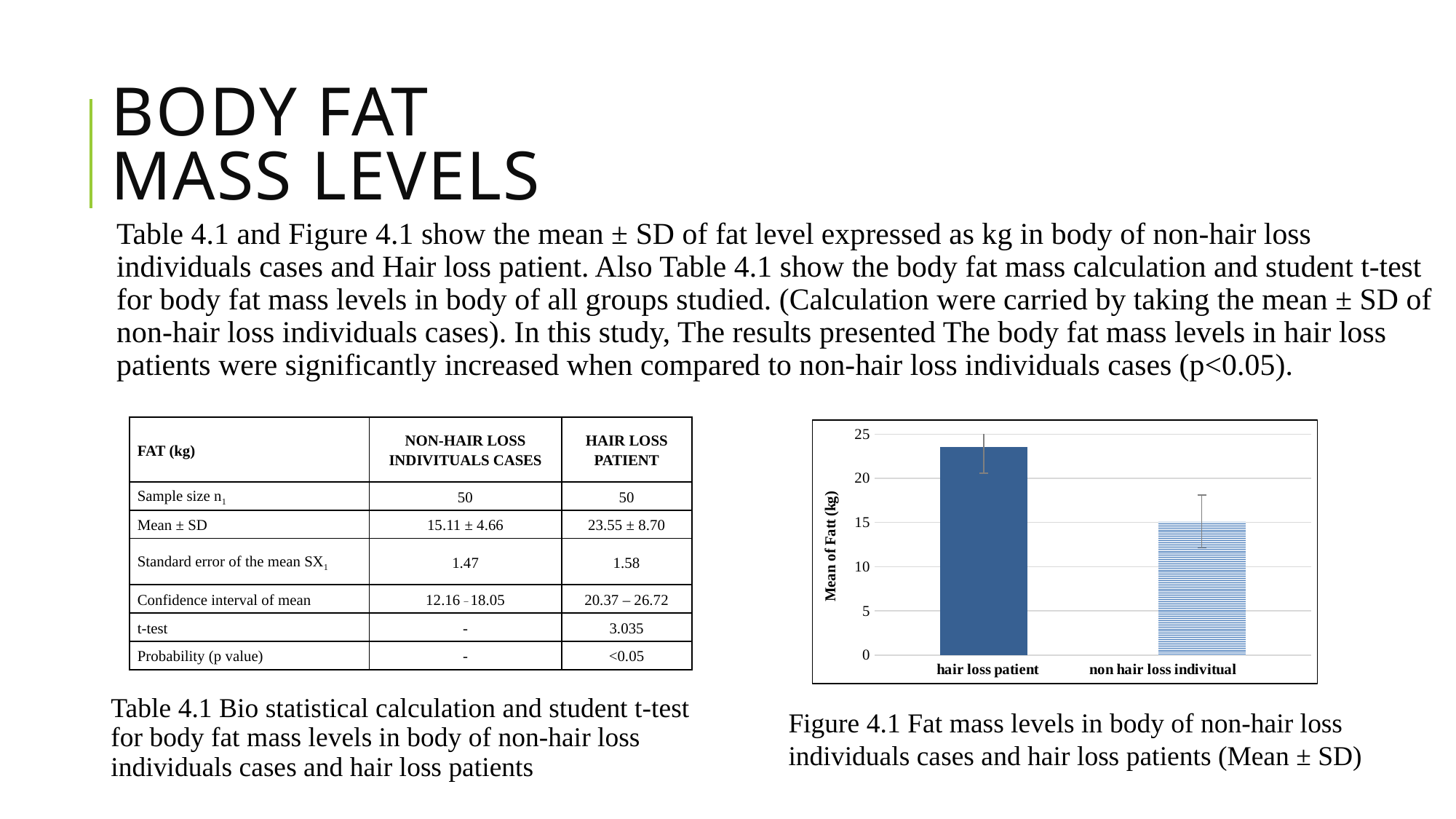
Is the value for hair loss patient greater or less than 25? less Which bar is taller, hair loss patient or non hair loss individual? hair loss patient Which category has the highest bar in the chart? hair loss patient How many categories are plotted on the x axis of the chart? 2 Is the value for non hair loss individual greater or less than 20? less Is the value for non hair loss individual greater or less than 10? greater What is the highest tick value shown on the y axis of the chart? 25 Do the bar values rise or fall from left to right along the x axis? fall What kind of chart is shown in Figure 4.1? bar chart Which category has the lowest bar in the chart? non hair loss individual What is the label on the y axis of the chart? Mean of Fatt (kg)